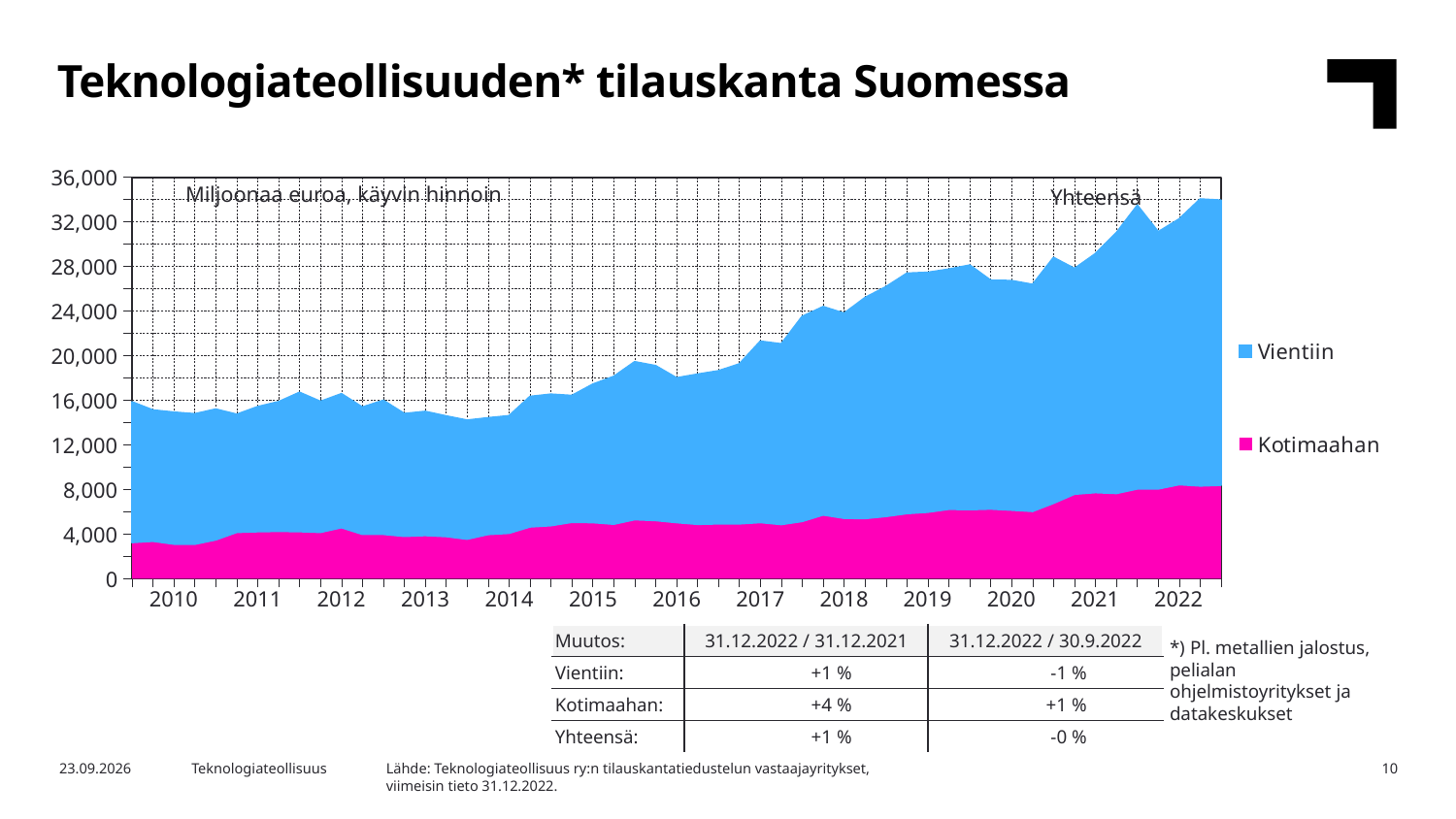
Which colour represents the Kotimaahan series in the chart? Magenta (pink) Is the total value (Yhteensä) in 2016 greater or less than 28,000? less Is the Kotimaahan value at the start of 2010 greater or less than 4,000? less Is the Kotimaahan value at the end of 2022 greater or less than 4,000? greater Which series is larger at the end of 2022, Vientiin or Kotimaahan? Vientiin What are the two series named in the chart legend? Vientiin and Kotimaahan What kind of chart is shown on the slide? Stacked area chart Does the total order book (Yhteensä) rise or fall overall from 2010 to 2022? Rise How many series does the chart legend list? 2 How many years are labelled on the x axis of the chart? 13